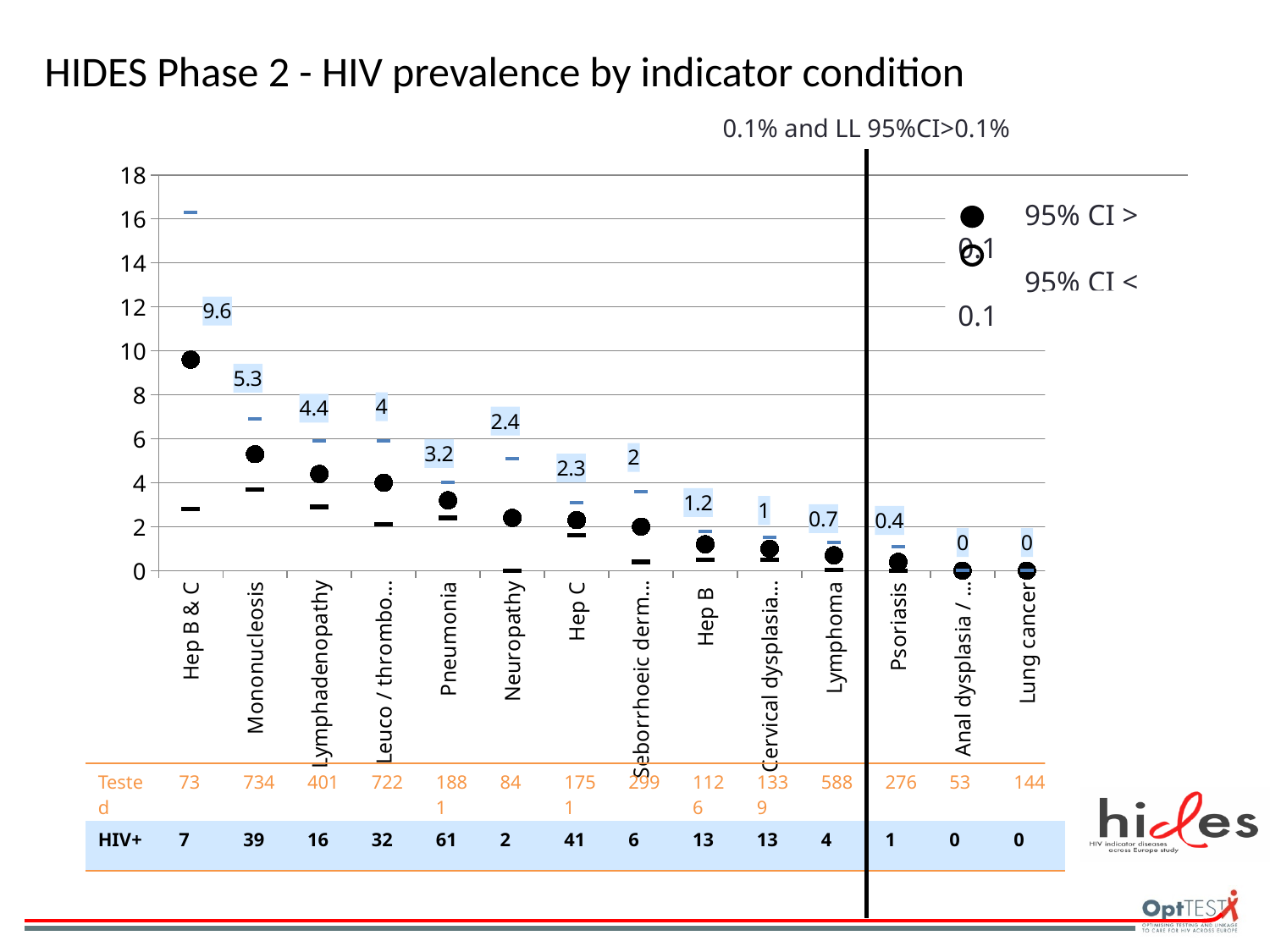
How many indicator conditions are plotted on the x axis? 14 What is the title of the slide's chart? HIDES Phase 2 - HIV prevalence by indicator condition Do the HIV prevalence values rise or fall from left to right along the x axis? fall What is the HIV prevalence value shown for Pneumonia? 3.2 What is the difference between the HIV prevalence for Hep B & C and for Mononucleosis? 4.3 Which has a higher HIV prevalence, Lymphadenopathy or Hep C? Lymphadenopathy What is the HIV prevalence value shown for Hep B & C? 9.6 What is the HIV prevalence value shown for Lymphoma? 0.7 What kind of chart is used to show HIV prevalence by indicator condition? scatter chart How many people were tested for Mononucleosis according to the table below the chart? 734 How many HIV+ cases are listed for Pneumonia in the table below the chart? 61 Which indicator condition has the highest HIV prevalence? Hep B & C